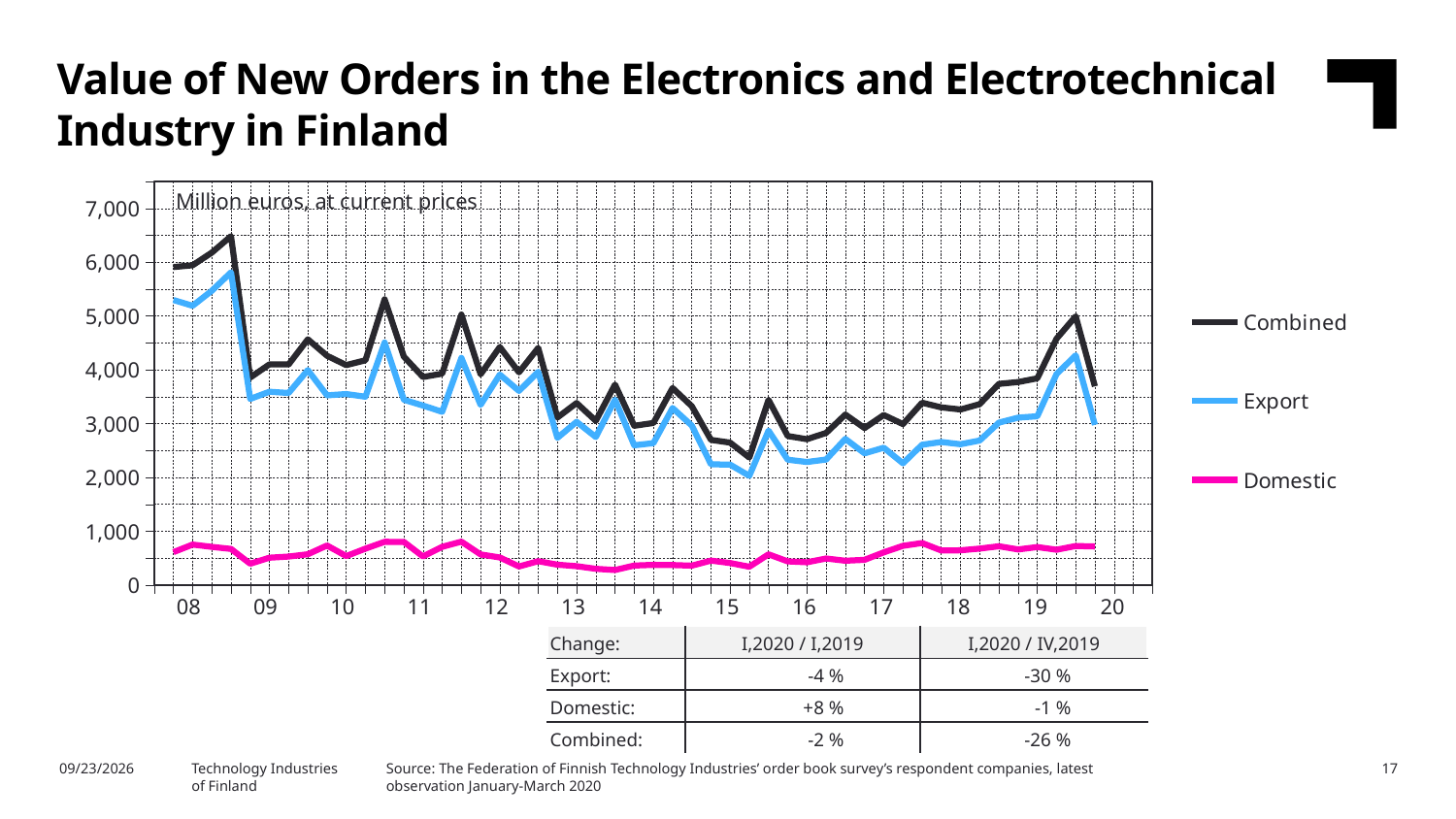
Is the value for Combined at the start of 2008 greater or less than 5,000? greater Is the value for Export in 2016 greater or less than 3,000? less What kind of chart is shown on the slide? Line chart Is the value for Domestic in 2015 greater or less than 1,000? less What unit label is shown at the top of the chart's plot area? Million euros, at current prices Does the Combined series generally rise or fall from 2008 to 2016? fall Which is larger in 2012, the Export value or the Domestic value? Export What colour is the Domestic line in the chart? Pink How many series does the chart legend list? 3 Which series in the chart has the lowest values throughout the period? Domestic Which series in the chart has the highest values throughout the period? Combined